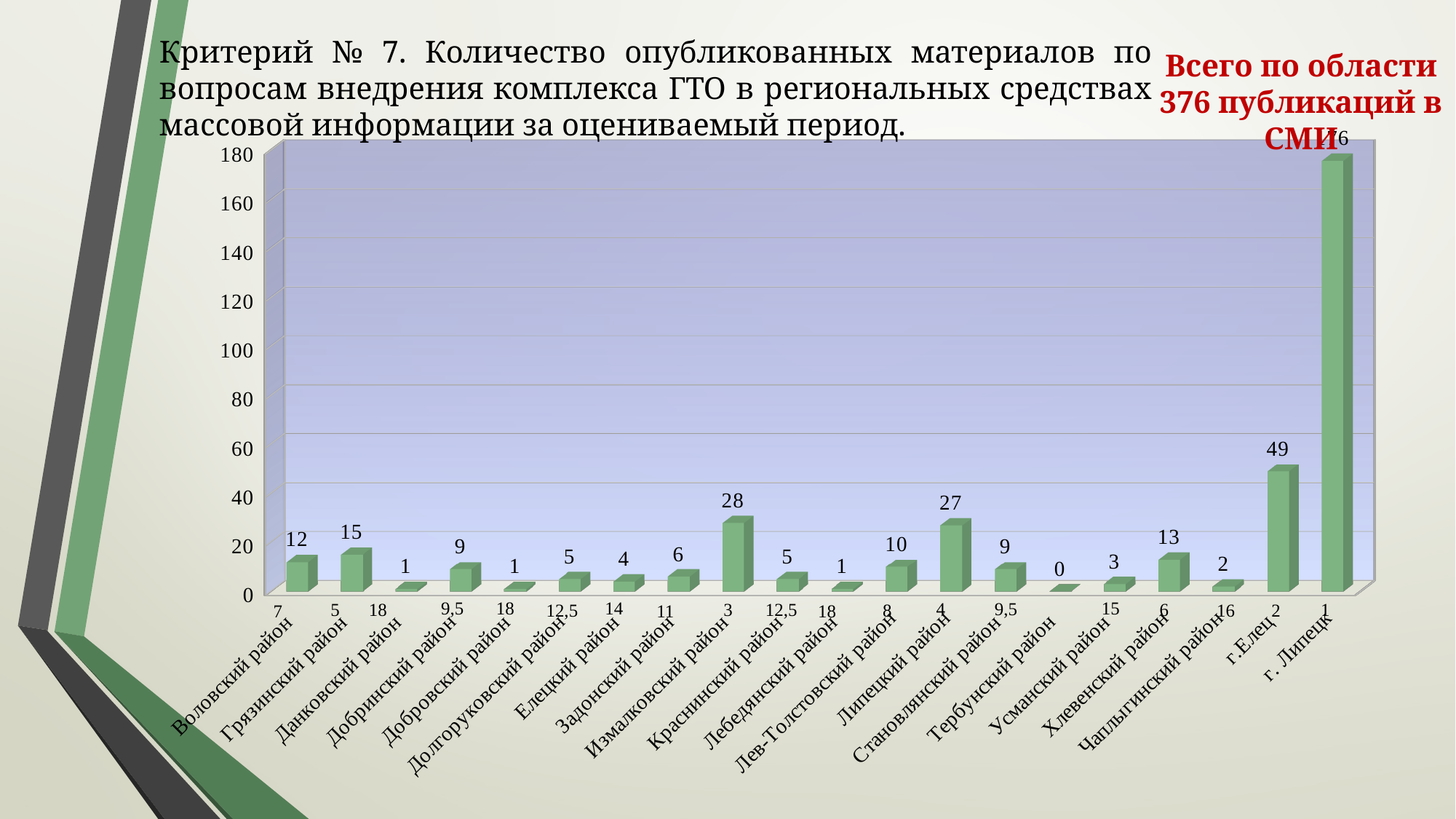
What is the difference between the values for г.Елец and Измалковский район? 21 What is the value for г.Елец? 49 What kind of chart is shown on the slide? bar chart According to the red text on the slide, how many publications were there in total for the region? 376 How many categories are shown on the x axis? 20 What is the value for Измалковский район? 28 Which category has the highest bar? г. Липецк What is the value for Липецкий район? 27 Which is larger, the value for Грязинский район or Воловский район? Грязинский район Is the value for г. Липецк greater or less than 160? greater Which category has the lowest value? Тербунский район What is the value for Хлевенский район? 13